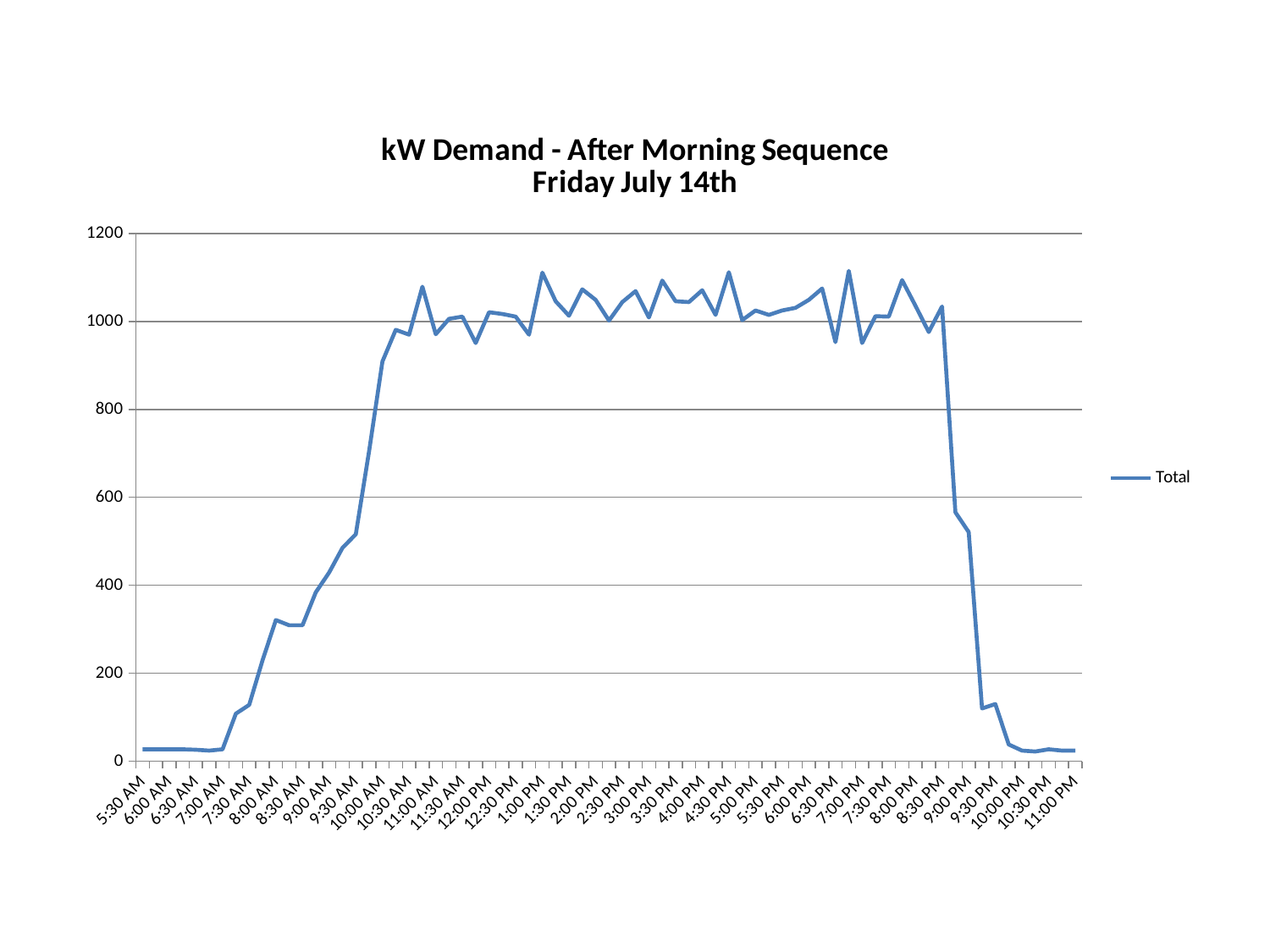
Does the value rise or fall between 8:30 PM and 10:00 PM? fall How many series does the legend list? 1 What kind of chart is shown on the slide? line chart Is the value for 5:30 AM greater or less than 200? less Is the value for 10:00 PM greater or less than 200? less Is the value for 1:00 PM greater or less than 1000? greater Does the value rise or fall between 7:00 AM and 10:00 AM? rise What is the title of the chart? kW Demand - After Morning Sequence Friday July 14th What is the name of the series shown in the legend? Total